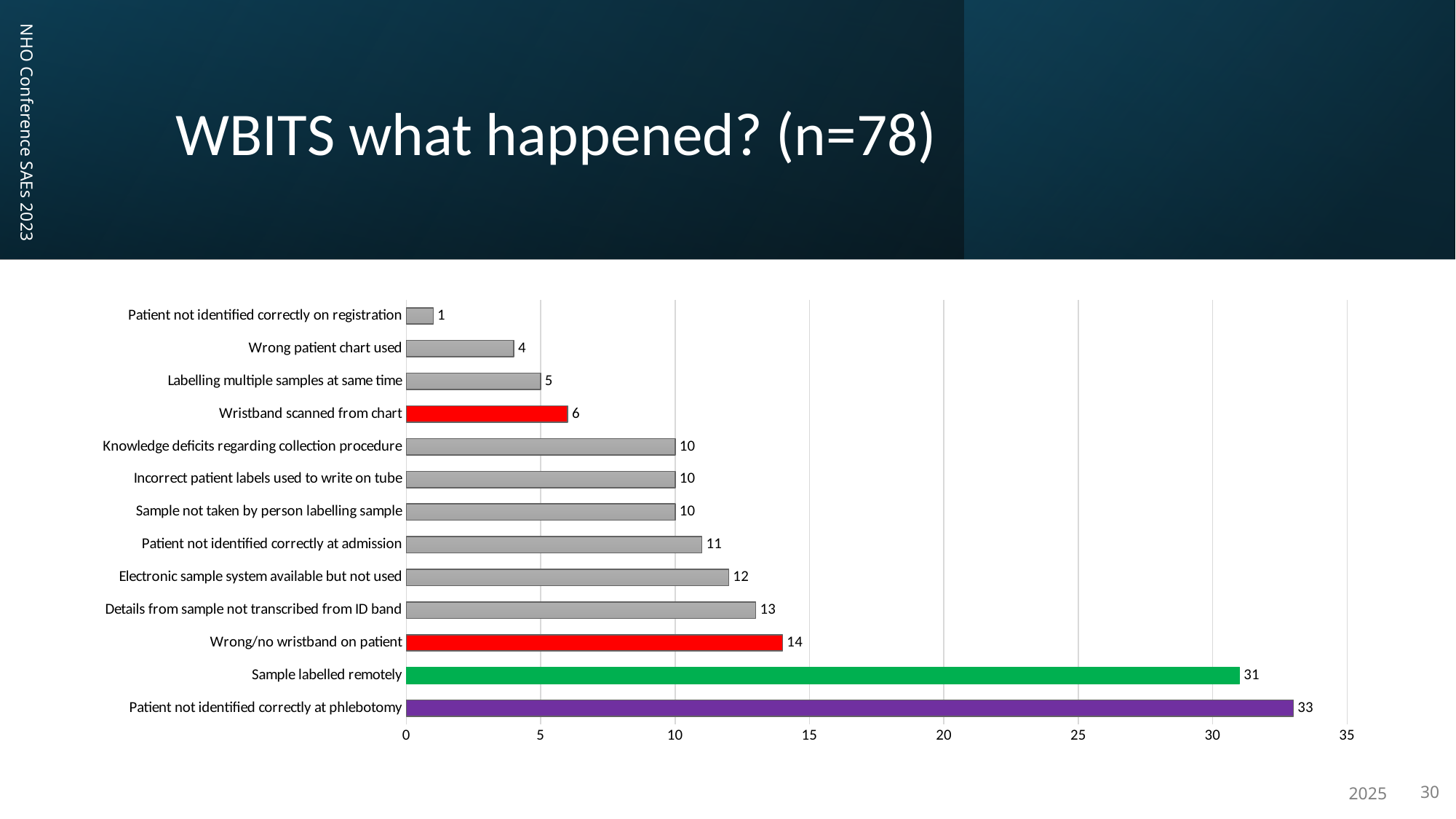
What is the title of the slide? WBITS what happened? (n=78) Which is larger: 'Details from sample not transcribed from ID band' or 'Electronic sample system available but not used'? Details from sample not transcribed from ID band Which category has the lowest value? Patient not identified correctly on registration How many categories are shown in the chart? 13 What kind of chart is shown on the slide? bar chart What is the value for 'Sample labelled remotely'? 31 What is the value for 'Wristband scanned from chart'? 6 Which category has the highest value? Patient not identified correctly at phlebotomy Is the value for 'Wrong/no wristband on patient' greater or less than 10? greater What is the value for 'Wrong/no wristband on patient'? 14 What colour is the bar for 'Sample labelled remotely'? green What is the difference between 'Patient not identified correctly at phlebotomy' and 'Sample labelled remotely'? 2